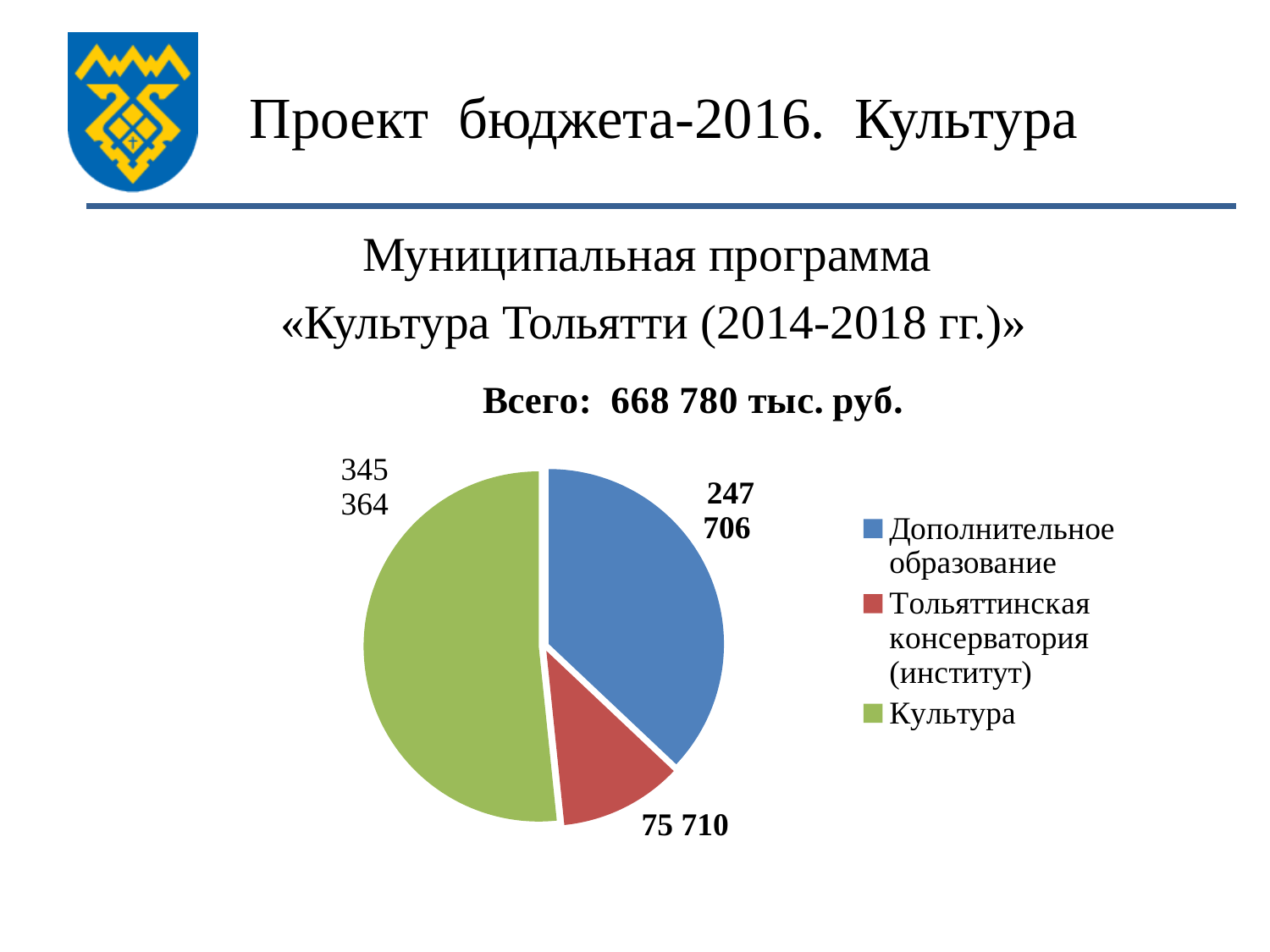
What total amount is stated above the chart? 668 780 тыс. руб. How many categories does the pie chart have? 3 What type of chart is shown on the slide? pie chart What is the difference between the values for Дополнительное образование and Тольяттинская консерватория (институт)? 171 996 Which is larger, the value for Дополнительное образование or the value for Тольяттинская консерватория (институт)? Дополнительное образование Which category has the largest slice of the pie? Культура Which category has the smallest slice of the pie? Тольяттинская консерватория (институт) What is the value for Дополнительное образование? 247 706 What is the value for Культура? 345 364 What is the difference between the values for Культура and Дополнительное образование? 97 658 Which colour represents Культура in the pie chart? green What is the value for Тольяттинская консерватория (институт)? 75 710